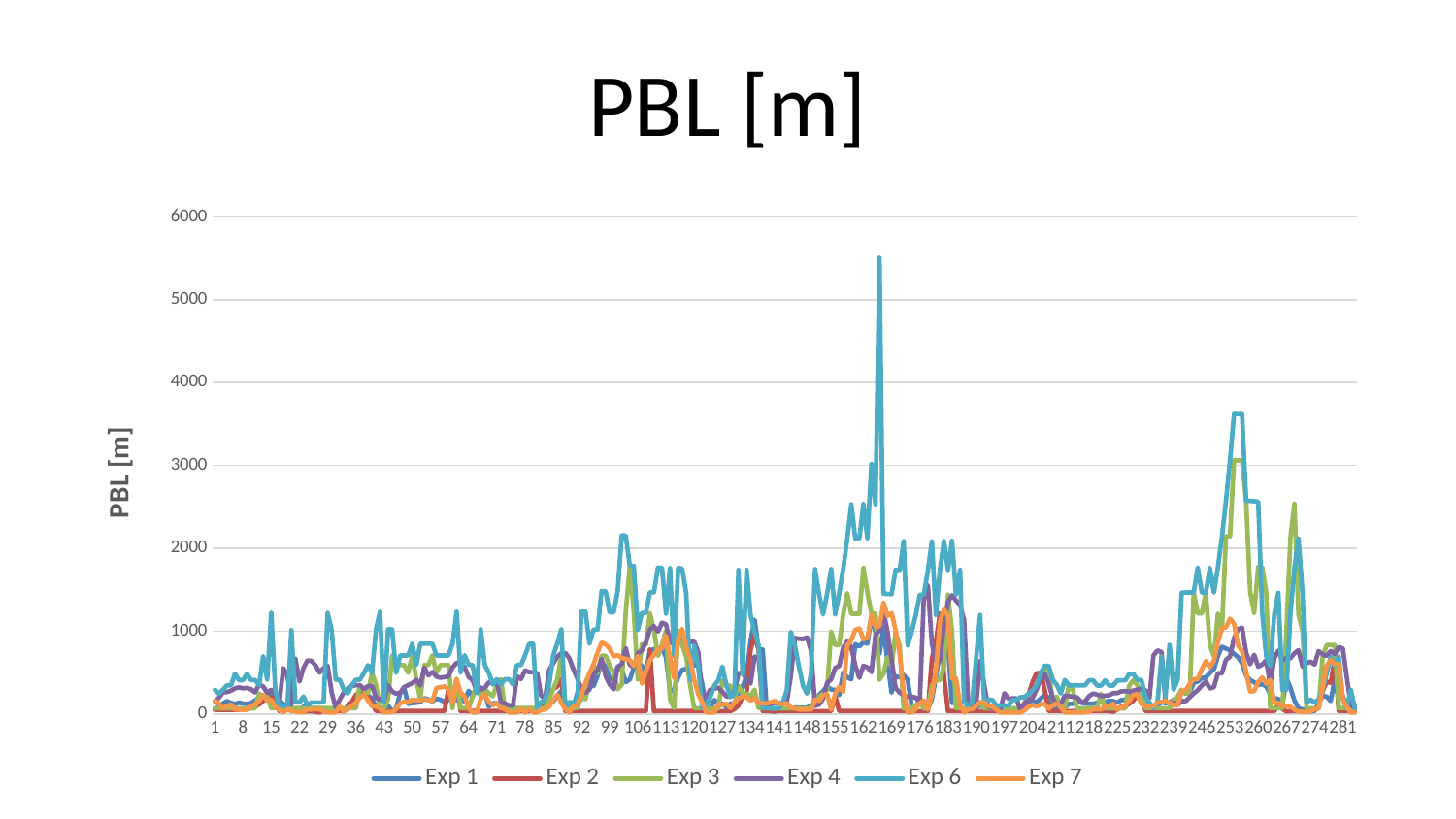
What is the title of the chart? PBL [m] Is the highest value of Exp 7 greater or less than 2000? less What type of chart is shown on the slide? line chart Is the highest value of Exp 4 greater or less than 2000? less Which series reaches the highest value on the chart? Exp 6 Is the highest value of Exp 2 greater or less than 2000? less Which series stays closest to zero for most of the x axis? Exp 2 Which series reaches a higher maximum, Exp 6 or Exp 2? Exp 6 Which experiment number between 1 and 7 is missing from the legend? Exp 5 Which series reaches a higher maximum, Exp 3 or Exp 7? Exp 3 How many series does the legend list? 6